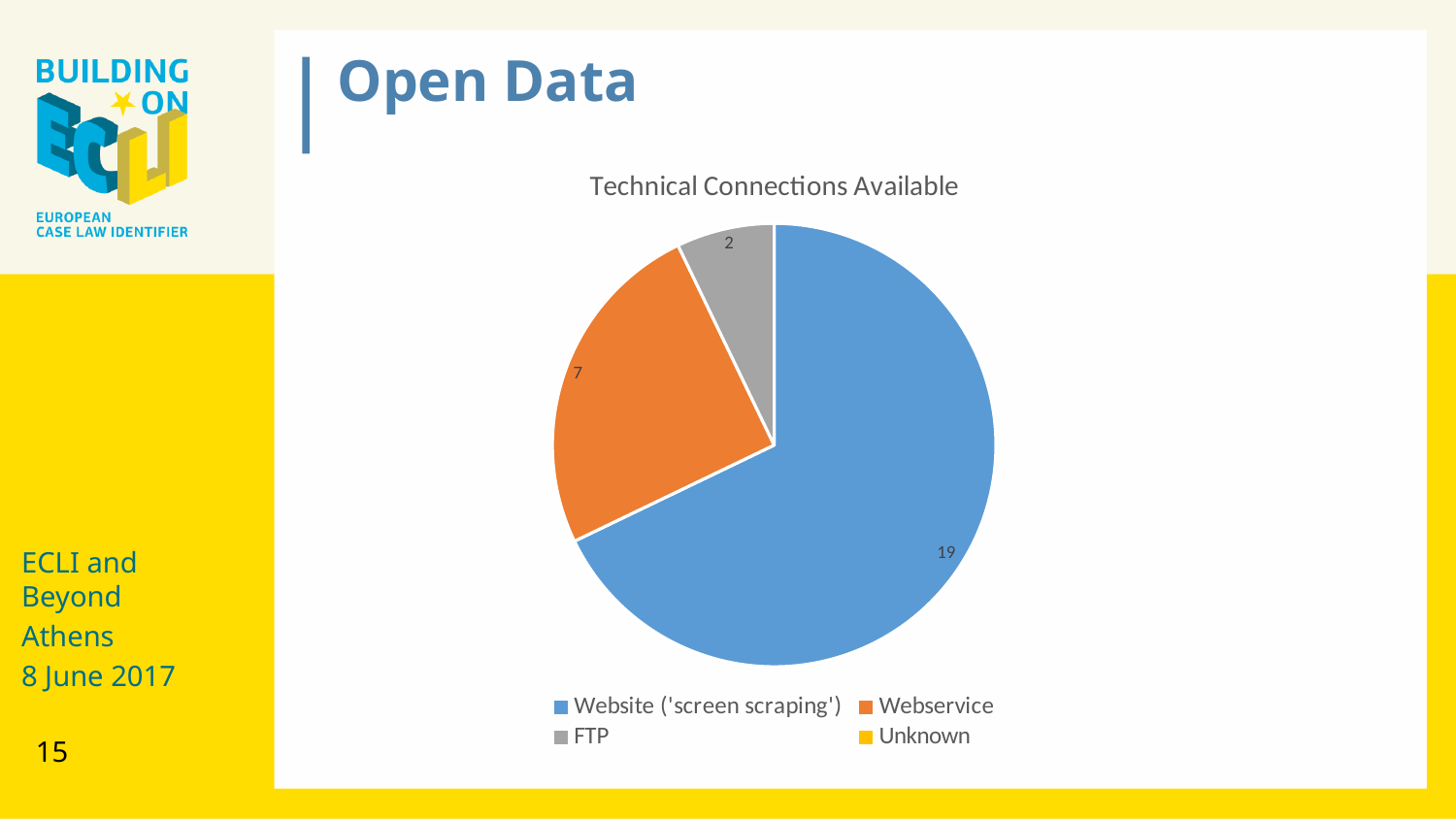
What is the value for FTP? 2 What is the value for Website ('screen scraping')? 19 What is the difference between the values for Webservice and FTP? 5 What is the title of the chart? Technical Connections Available What is the difference between the values for Website ('screen scraping') and Webservice? 12 Which is larger, the value for Webservice or the value for FTP? Webservice What is the value for Webservice? 7 Which labelled category has the smallest slice of the pie? FTP Which category has the largest slice of the pie? Website ('screen scraping') How many entries does the chart legend list? 4 What colour is the Webservice slice? orange What type of chart is shown on the slide? pie chart